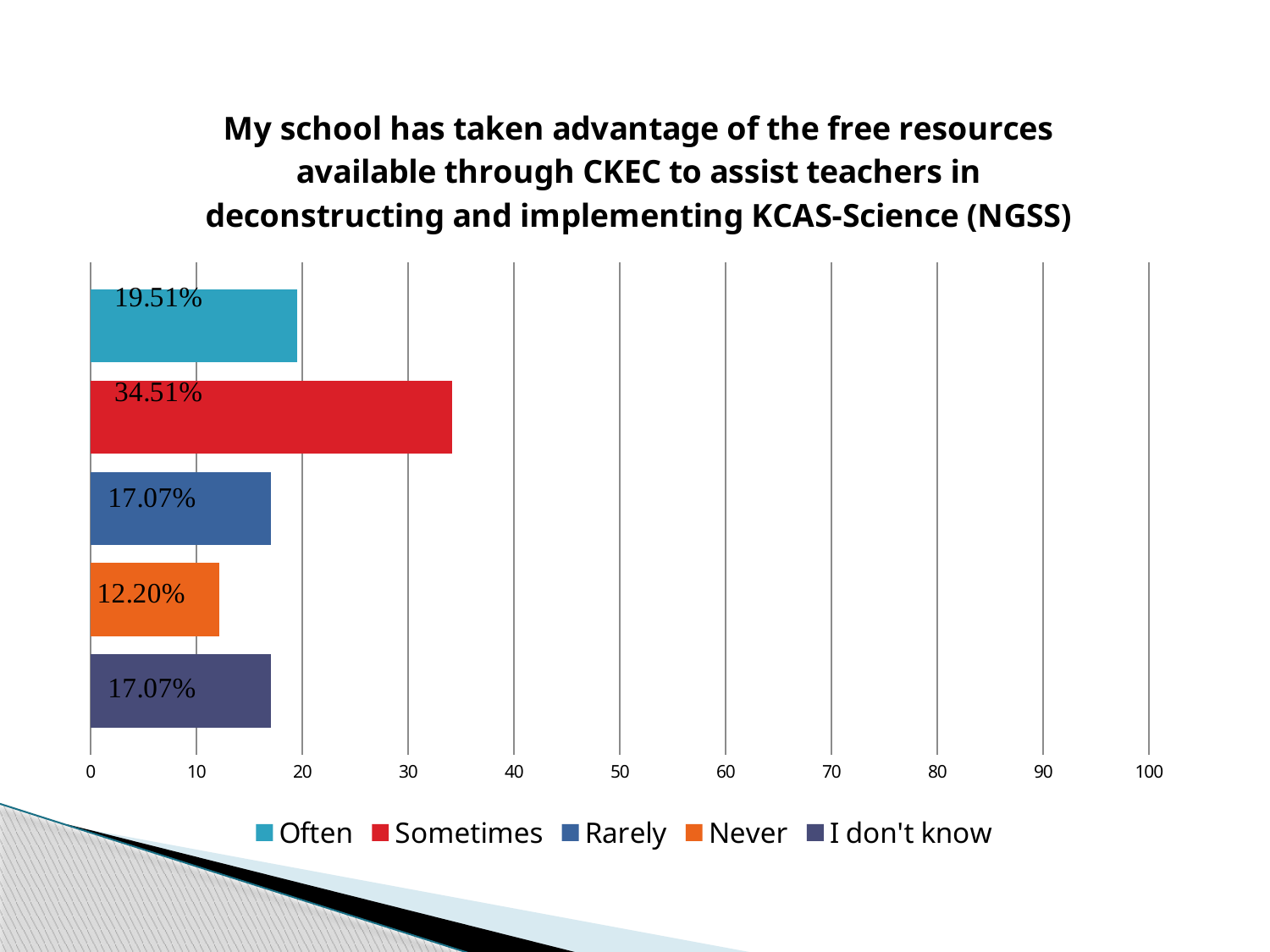
Is the value for Sometimes greater or less than 30? greater What is the value for Often? 19.51% What is the value for Sometimes? 34.51% How many bars are plotted on the chart? 5 What is the value for Rarely? 17.07% What is the value for Never? 12.20% What kind of chart is shown on the slide? Bar chart Which is larger, the value for Often or the value for Never? Often How many series does the legend list? 5 Which response has the highest value? Sometimes Which response has the lowest value? Never What is the difference between the values for Sometimes and Often? 15.00%